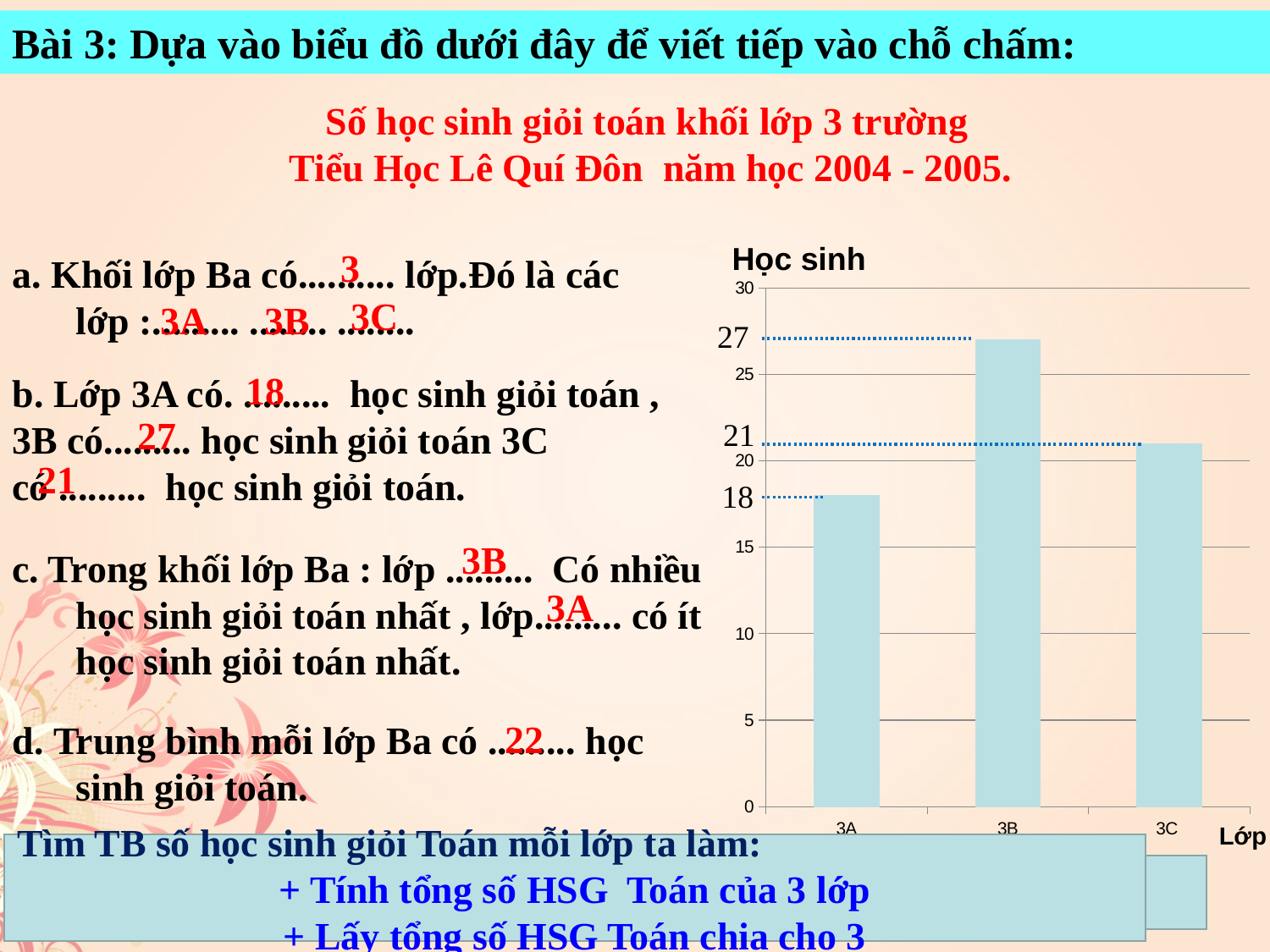
What is the difference between the values for 3C and 3A? 3 What kind of chart is shown on the slide? bar chart How many classes (categories) are shown on the x axis of the chart? 3 Which is larger, the value for 3C or the value for 3A? 3C What is the value for class 3B in the chart? 27 What is the value for class 3A in the chart? 18 Which class has the lowest bar in the chart? 3A What label is shown on the vertical axis of the chart? Học sinh What is the difference between the values for 3B and 3A? 9 What is the value for class 3C in the chart? 21 Is the value for 3B greater or less than 25? greater Which class has the highest bar in the chart? 3B